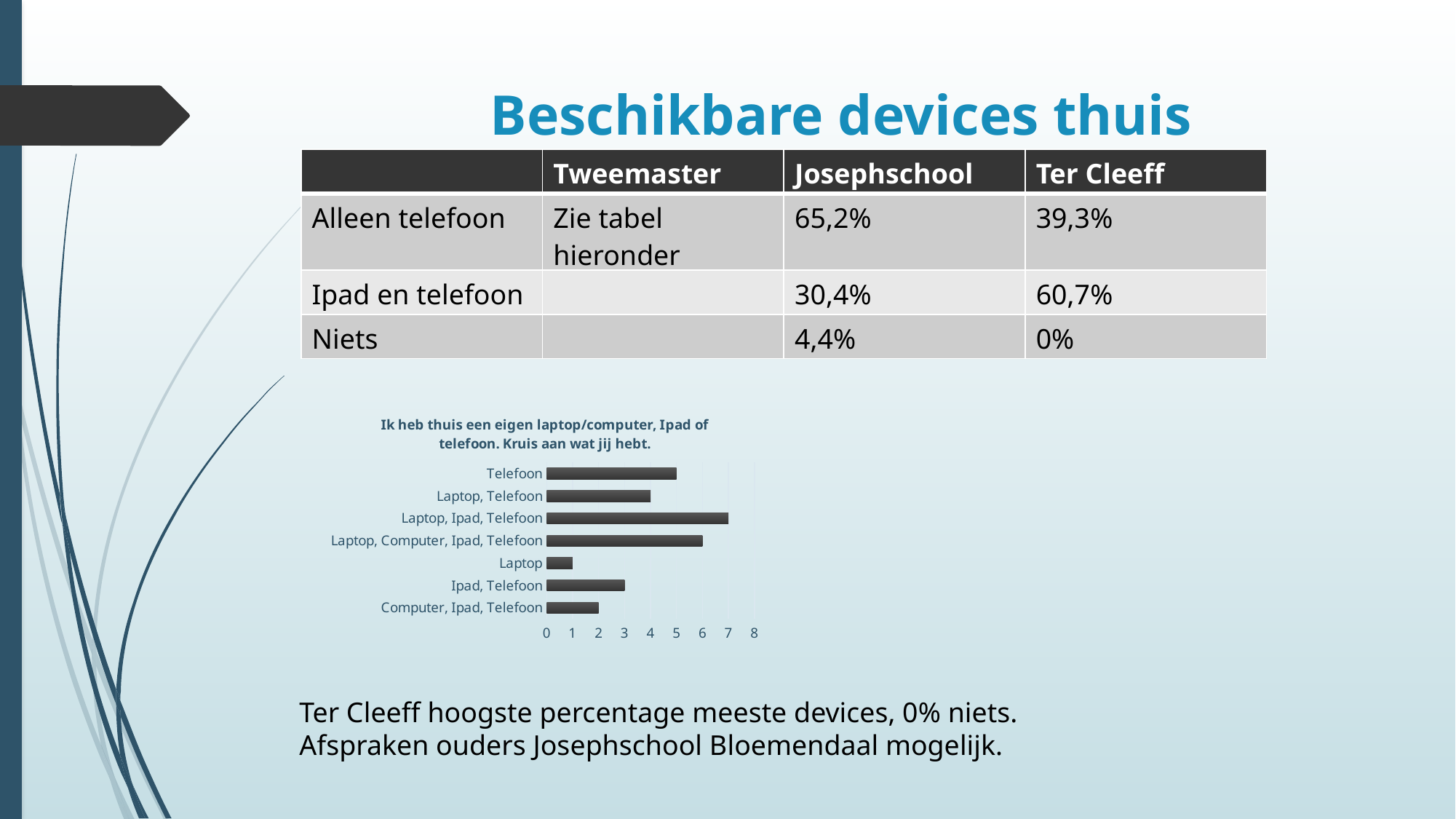
Which category has the lowest value in the bar chart? Laptop What kind of chart is shown on the slide? bar chart What is the difference between the values for Laptop, Ipad, Telefoon and Laptop, Telefoon? 3 Is the value for Computer, Ipad, Telefoon greater or less than 4? less Is the value for Laptop, Computer, Ipad, Telefoon greater or less than 4? greater How many categories does the bar chart show? 7 What is the value for Laptop, Ipad, Telefoon in the bar chart? 7 What is the highest value shown on the x axis of the bar chart? 8 What is the value for Telefoon in the bar chart? 5 Which is larger in the bar chart: Ipad, Telefoon or Computer, Ipad, Telefoon? Ipad, Telefoon Which category has the highest value in the bar chart? Laptop, Ipad, Telefoon What is the value for Laptop in the bar chart? 1